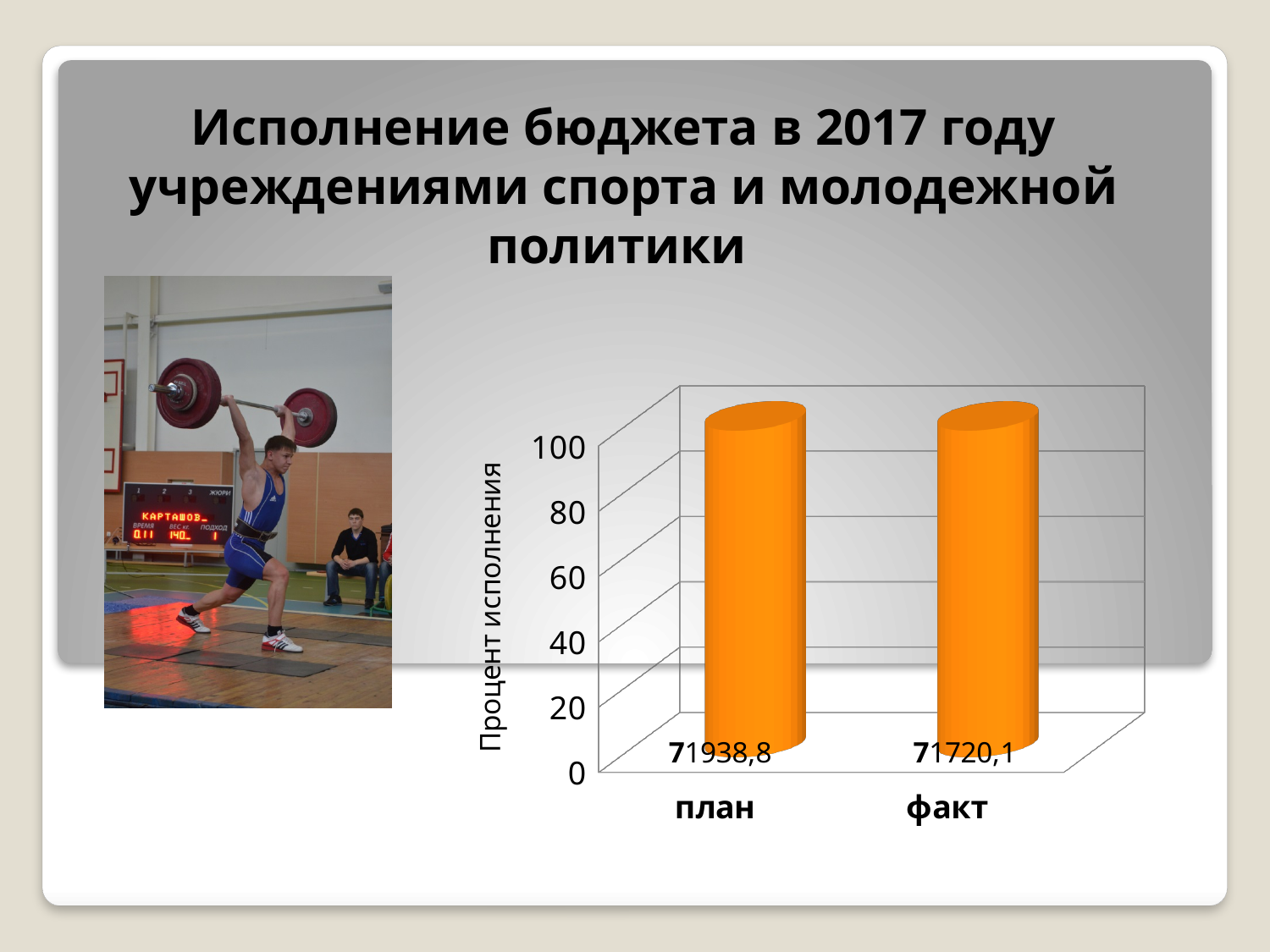
What value is labelled on the bar for факт? 71720,1 What is the title of the vertical axis of the chart? Процент исполнения What value is labelled on the bar for план? 71938,8 Is the bar for факт greater or less than 60 on the vertical axis? greater What are the two category labels on the horizontal axis of the chart? план, факт Which category has the larger labelled value, план or факт? план What is the highest tick value shown on the vertical axis? 100 Is the bar for план greater or less than 80 on the vertical axis? greater What kind of chart is shown on the slide? bar chart What is the difference between the labelled values for план and факт? 218,7 How many categories are shown on the chart? 2